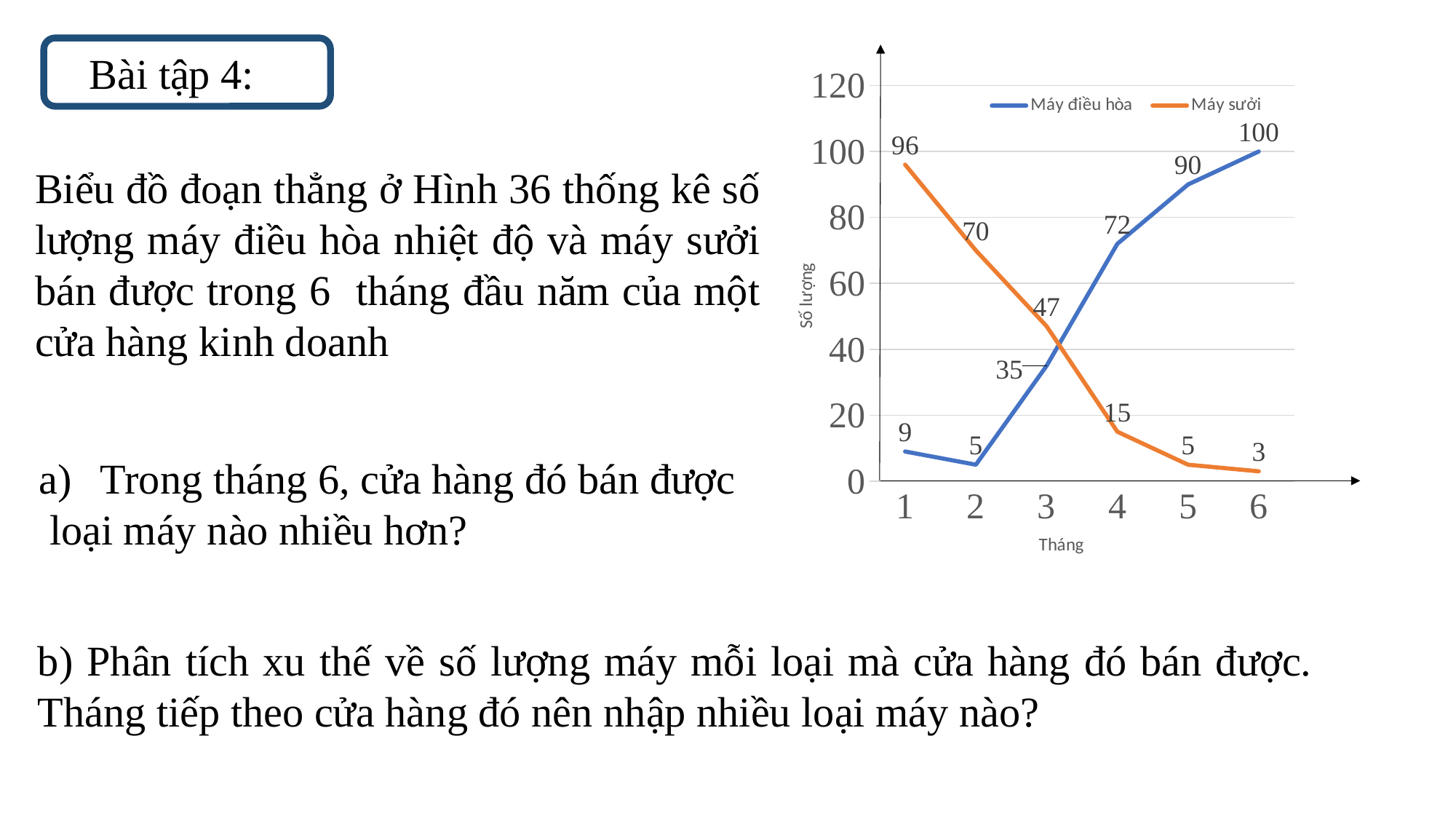
What is the label of the y axis? Số lượng What kind of chart is shown on the slide? line chart In which month is the value for Máy điều hòa highest? 6 What is the difference between Máy điều hòa and Máy sưởi in month 6? 97 What is the value for Máy sưởi in month 1? 96 How many series does the legend list? 2 What is the value for Máy điều hòa in month 4? 72 How many months are plotted on the x axis? 6 In month 2, which series has the larger value, Máy điều hòa or Máy sưởi? Máy sưởi In which month is the value for Máy sưởi lowest? 6 What is the value for Máy sưởi in month 3? 47 Do the values for Máy sưởi rise or fall from month 1 to month 6? fall